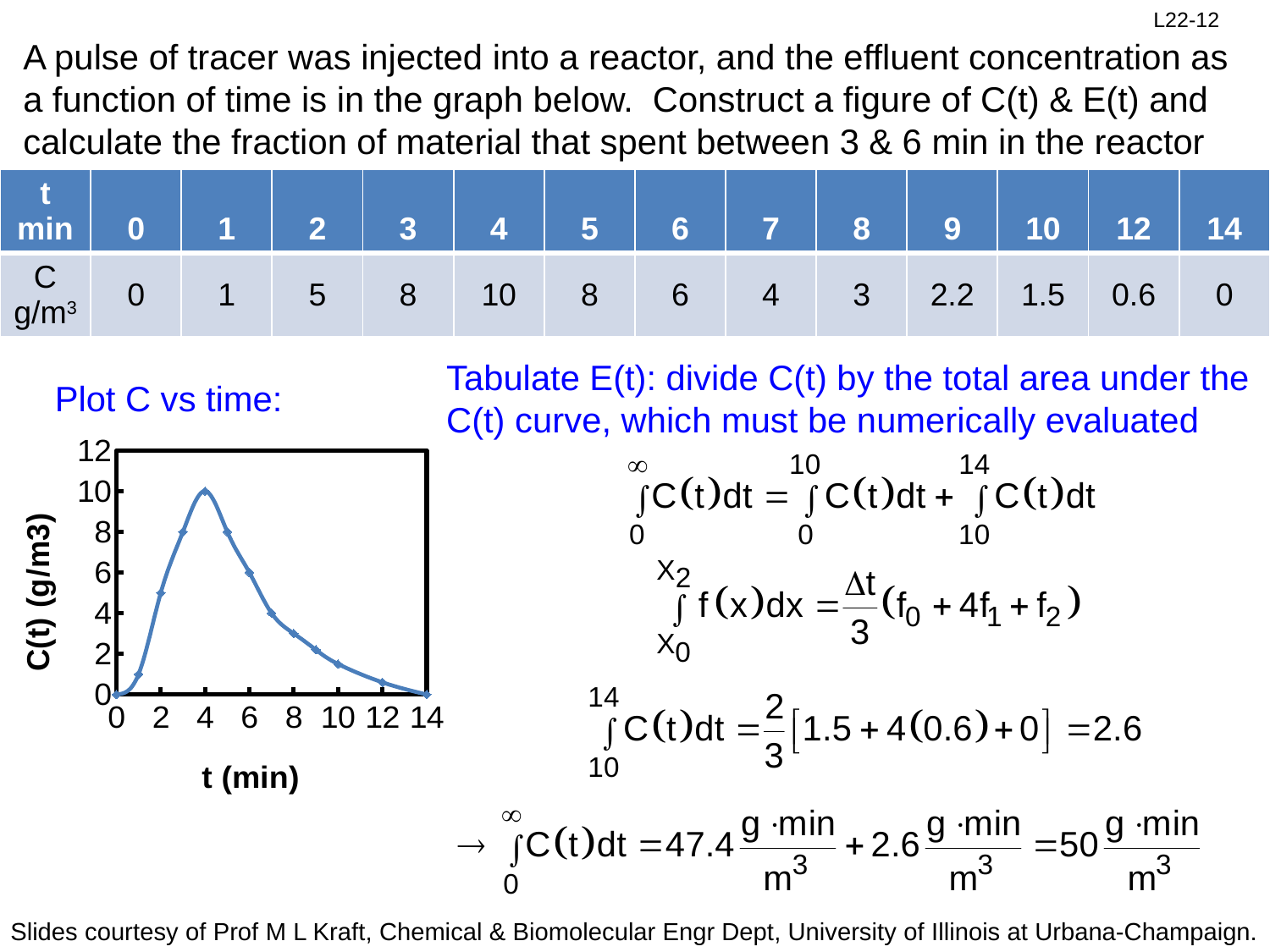
What kind of chart is the plot of C vs time? line chart Which is larger, C(t) at t = 3 min or C(t) at t = 6 min? t = 3 min What is the label on the y axis of the C vs time plot? C(t) (g/m3) What is the difference between C(t) at t = 4 min and C(t) at t = 7 min? 6 What is the label on the x axis of the C vs time plot? t (min) Does C(t) rise or fall as t increases from 4 min to 14 min? fall Is the value of C(t) at t = 8 min greater or less than 4? less How many data points are plotted on the C vs time curve? 13 What is the value of C(t) at t = 4 min? 10 Is the value of C(t) at t = 2 min greater or less than 4? greater At which time t (min) does C(t) reach its highest value? 4 What is the value of C(t) at t = 14 min? 0